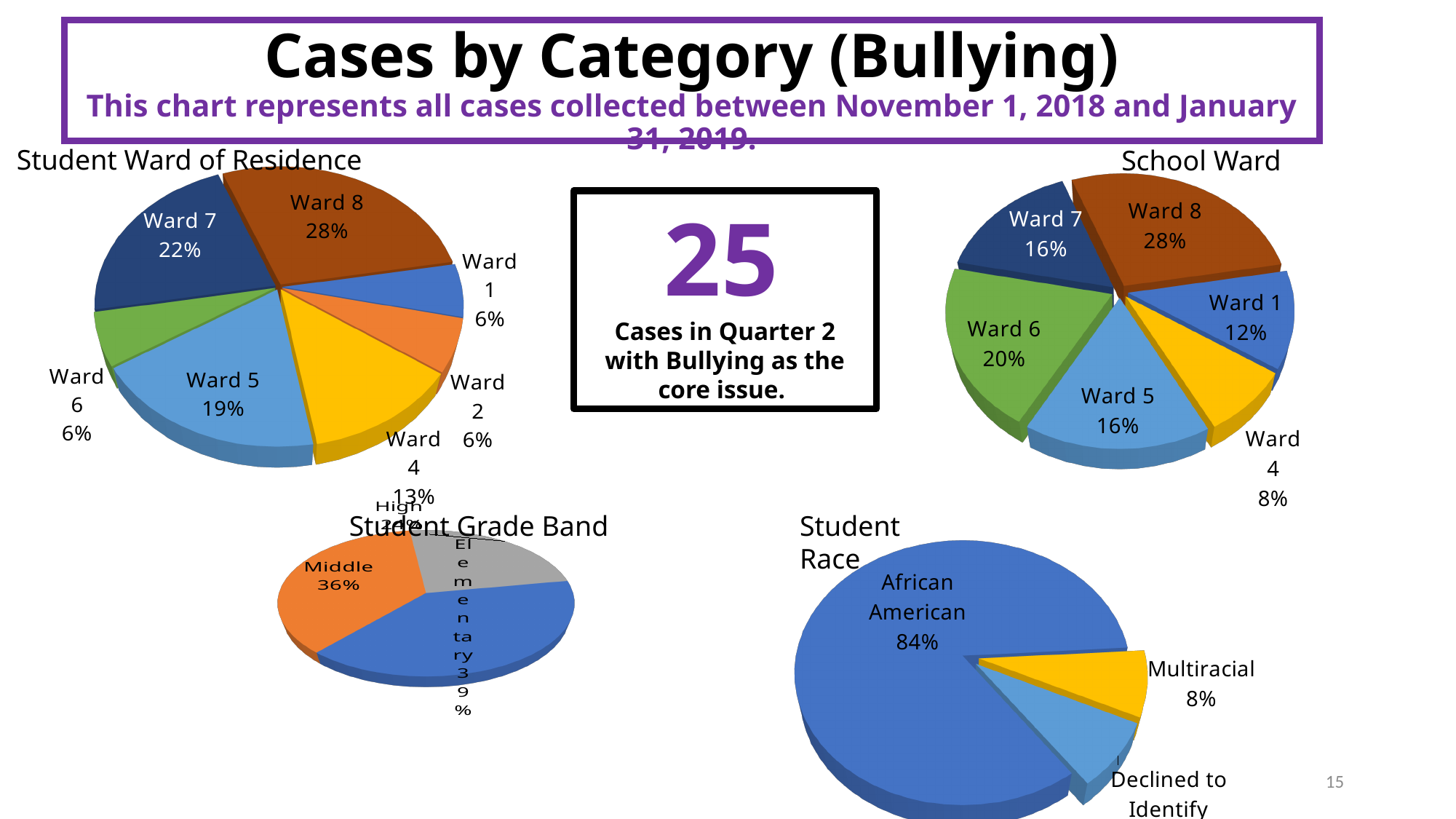
What type of chart is the Student Race chart? Pie chart In the School Ward chart, what percentage of cases is Ward 6? 20% In the Student Ward of Residence chart, what is the difference between the Ward 7 and Ward 5 shares? 3% In the School Ward chart, what percentage is Ward 1? 12% In the Student Ward of Residence chart, what percentage is Ward 4? 13% In the Student Race chart, what percentage of cases is African American? 84% Which chart shows a larger share for Ward 7, Student Ward of Residence or School Ward? Student Ward of Residence How many slices does the School Ward pie chart have? 6 In the Student Ward of Residence chart, what percentage of cases is Ward 8? 28% In the Student Grade Band chart, what percentage of cases is Middle? 36% In the Student Ward of Residence chart, which ward has the largest share? Ward 8 In the School Ward chart, which ward has the smallest share? Ward 4